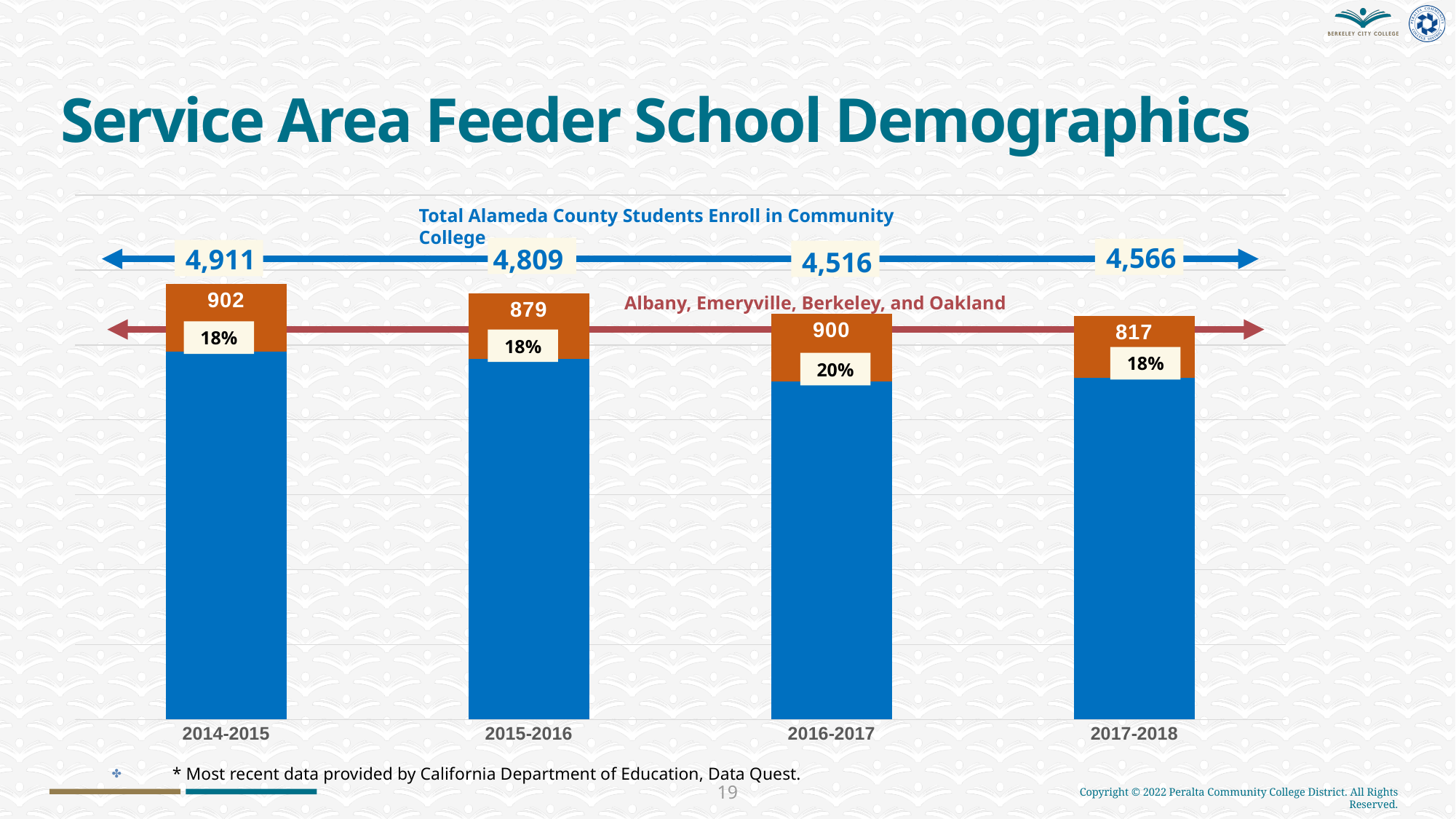
How many years are shown on the x axis of the chart? 4 What is the total number of Alameda County students enrolled in community college for 2016-2017? 4,516 What is the value for Albany, Emeryville, Berkeley, and Oakland in 2015-2016? 879 What is the difference between the total Alameda County students in 2014-2015 and 2015-2016? 102 What percentage is shown for 2016-2017? 20% Which is larger, the Albany, Emeryville, Berkeley, and Oakland value for 2014-2015 or for 2016-2017? 2014-2015 Which year has the lowest value for Albany, Emeryville, Berkeley, and Oakland? 2017-2018 Which year has the highest total of Alameda County students enrolled in community college? 2014-2015 What is the value for Albany, Emeryville, Berkeley, and Oakland in 2017-2018? 817 What kind of chart is shown on the slide? Bar chart What is the total number of Alameda County students enrolled in community college for 2014-2015? 4,911 What colour are the segments representing Albany, Emeryville, Berkeley, and Oakland? Orange